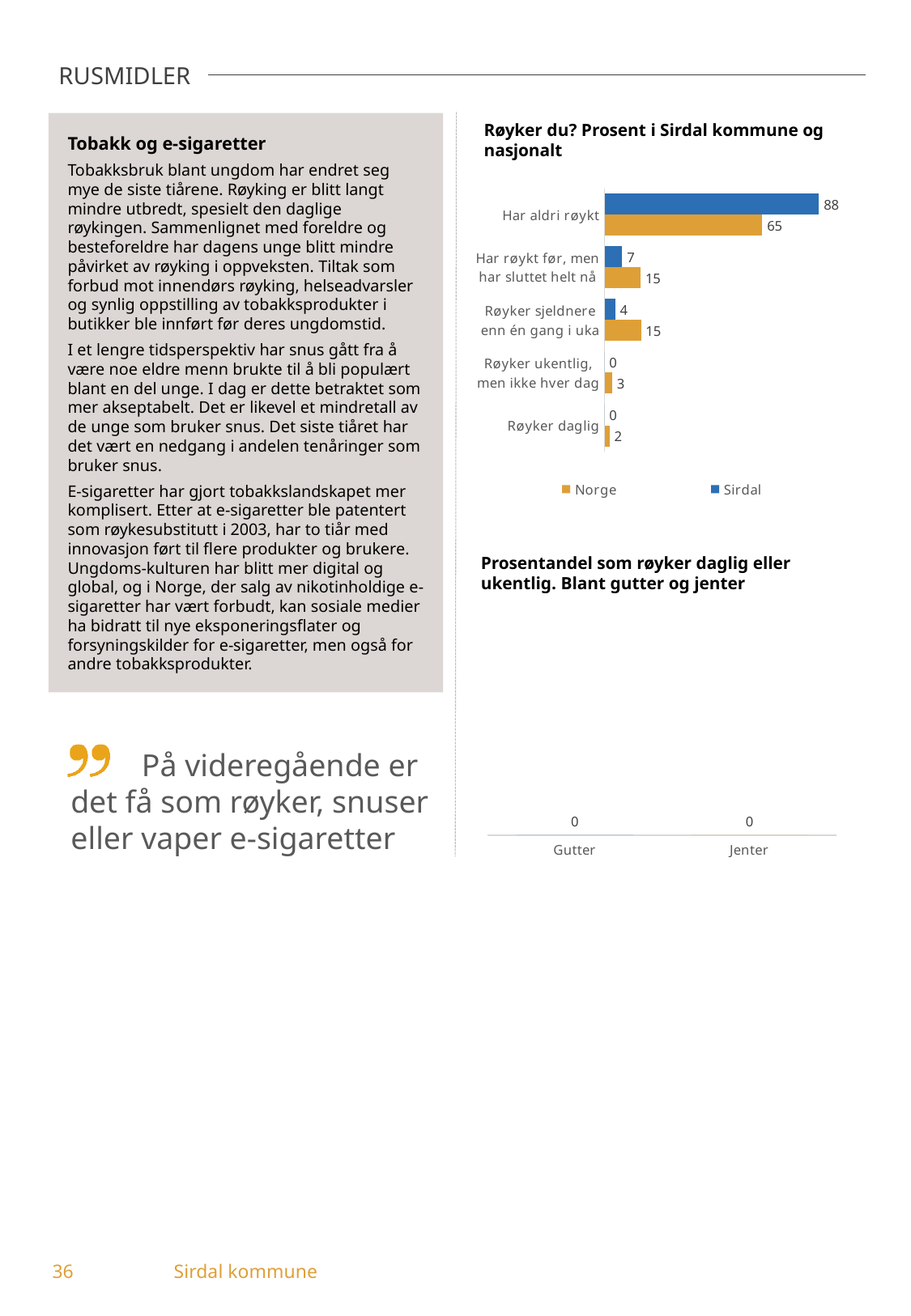
In the chart 'Røyker du? Prosent i Sirdal kommune og nasjonalt', what is the value for Sirdal for 'Har aldri røykt'? 88 What kind of chart is 'Røyker du? Prosent i Sirdal kommune og nasjonalt'? Bar chart How many series does the legend list in the chart 'Røyker du? Prosent i Sirdal kommune og nasjonalt'? 2 In the chart 'Røyker du? Prosent i Sirdal kommune og nasjonalt', which is larger for 'Har røykt før, men har sluttet helt nå': Norge or Sirdal? Norge In the chart 'Prosentandel som røyker daglig eller ukentlig. Blant gutter og jenter', what is the value for Jenter? 0 In the chart 'Røyker du? Prosent i Sirdal kommune og nasjonalt', what is the value for Sirdal for 'Har røykt før, men har sluttet helt nå'? 7 In the chart 'Røyker du? Prosent i Sirdal kommune og nasjonalt', what is the value for Norge for 'Har aldri røykt'? 65 In the chart 'Røyker du? Prosent i Sirdal kommune og nasjonalt', what is the difference between the Sirdal and Norge values for 'Har aldri røykt'? 23 In the chart 'Røyker du? Prosent i Sirdal kommune og nasjonalt', what is the value for Norge for 'Røyker sjeldnere enn én gang i uka'? 15 In the chart 'Røyker du? Prosent i Sirdal kommune og nasjonalt', which category has the highest value for Sirdal? Har aldri røykt How many categories are shown in the chart 'Røyker du? Prosent i Sirdal kommune og nasjonalt'? 5 In the chart 'Røyker du? Prosent i Sirdal kommune og nasjonalt', what is the value for Norge for 'Røyker daglig'? 2